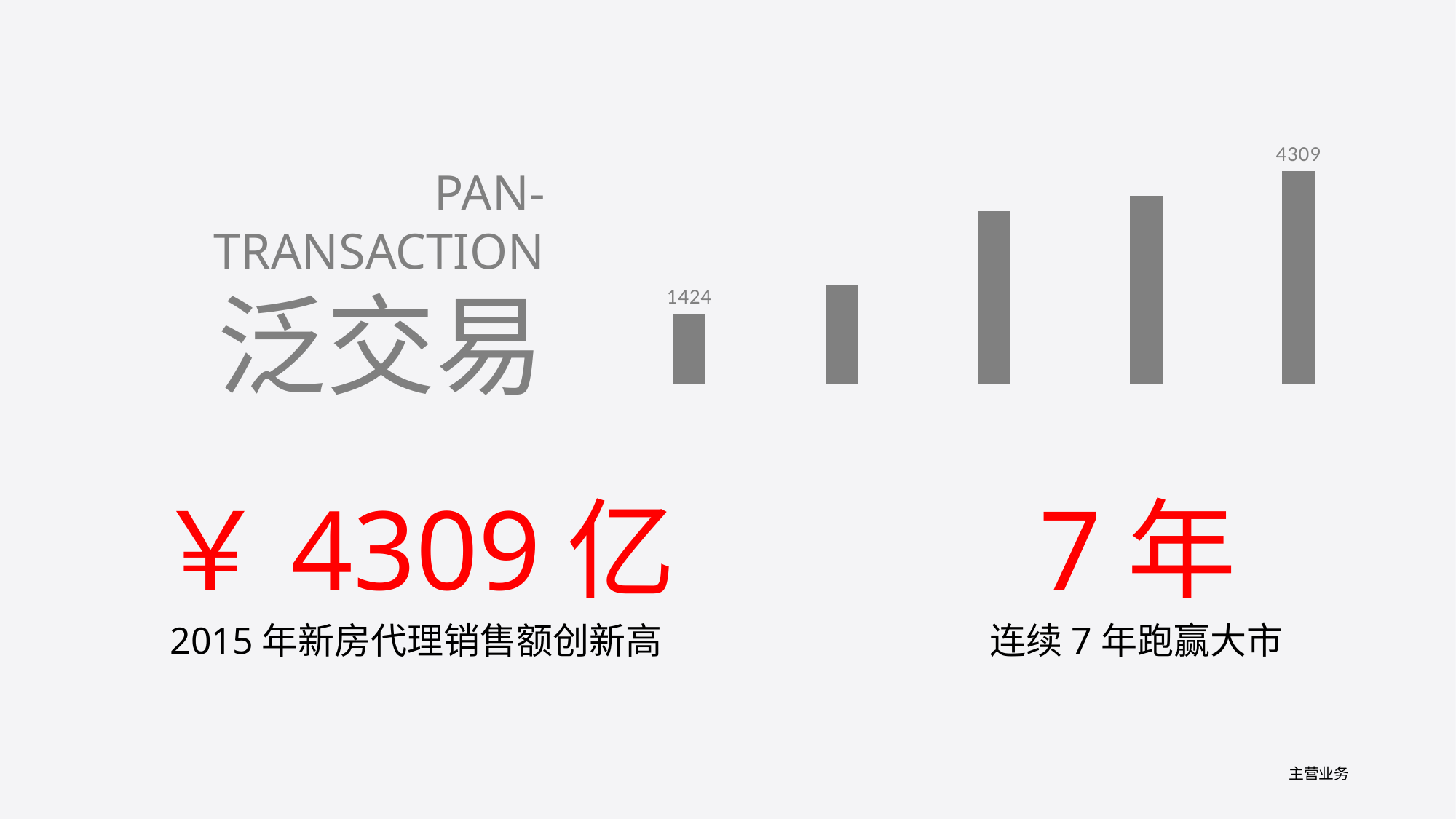
What is the difference between the rightmost bar's value and the leftmost bar's value? 2885 Which is larger, the leftmost bar's value or the rightmost bar's value? the rightmost bar's value What value is labelled on the leftmost bar of the chart? 1424 Which bar in the chart is the shortest? the leftmost bar (1424) How many bars does the chart contain? 5 What colour are the bars in the chart? grey Which bar in the chart is the tallest? the rightmost bar (4309) Do the bar values rise or fall from left to right across the chart? rise What value is labelled on the rightmost bar of the chart? 4309 How many bars in the chart have a printed data label? 2 What kind of chart is shown on the slide? bar chart